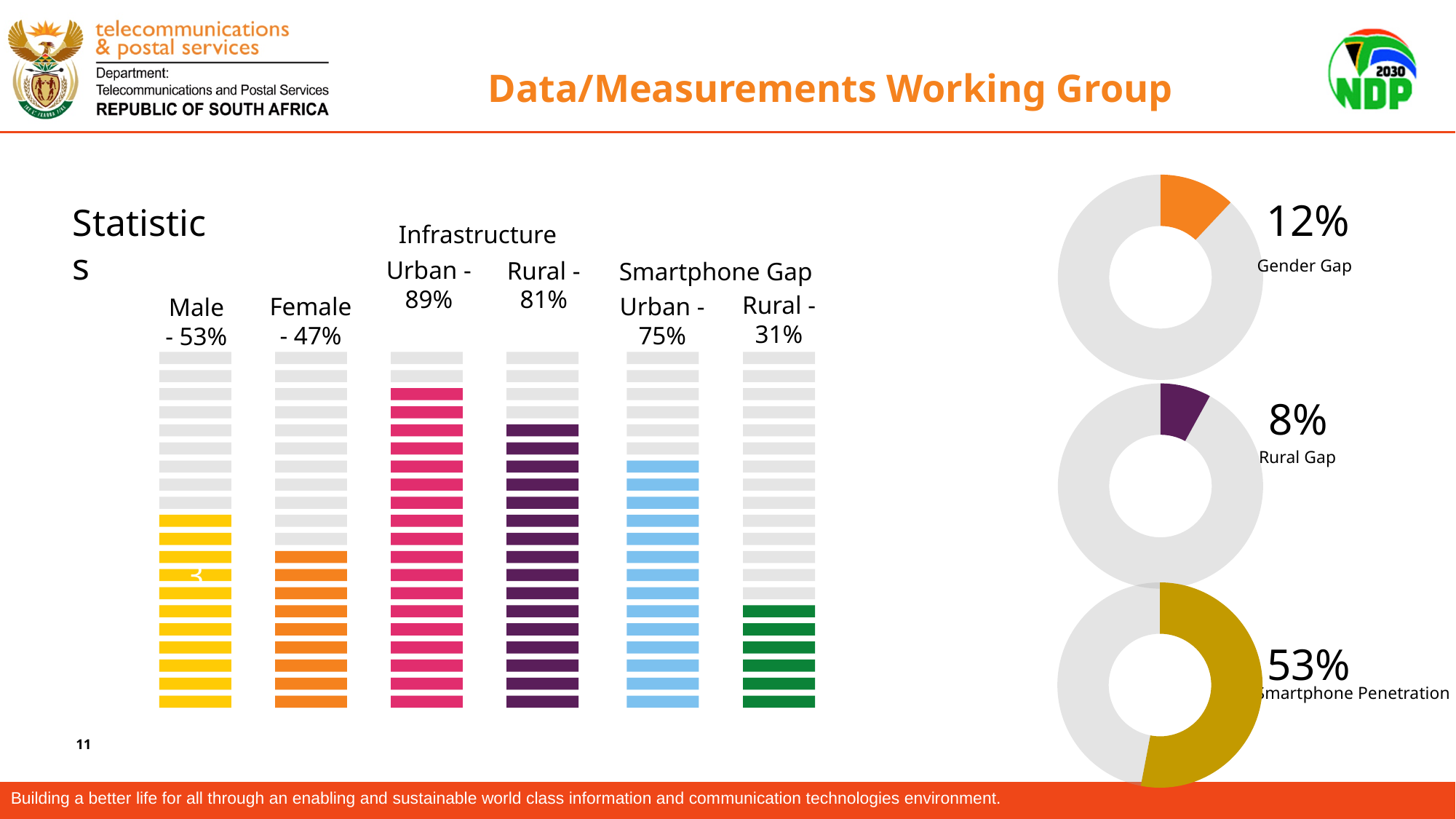
In the donut chart labelled Gender Gap, what percentage is shown? 12% Under Smartphone Gap, what is the value shown for Rural? 31% How many donut charts are shown on the right side of the slide? 3 In the donut chart labelled Smartphone Penetration, what percentage is shown? 53% In the bar graphic on the left, what is the value shown for Female? 47% Under Infrastructure, what is the value shown for Rural? 81% Under Infrastructure, what is the value shown for Urban? 89% Among the six bars on the left, which category has the highest value? Infrastructure Urban (89%) In the bar graphic on the left, what is the value shown for Male? 53% Under Smartphone Gap, what is the difference between the Urban and Rural values? 44% Under Infrastructure, which is larger, the Urban value or the Rural value? Urban Among the six bars on the left, which category has the lowest value? Smartphone Gap Rural (31%)